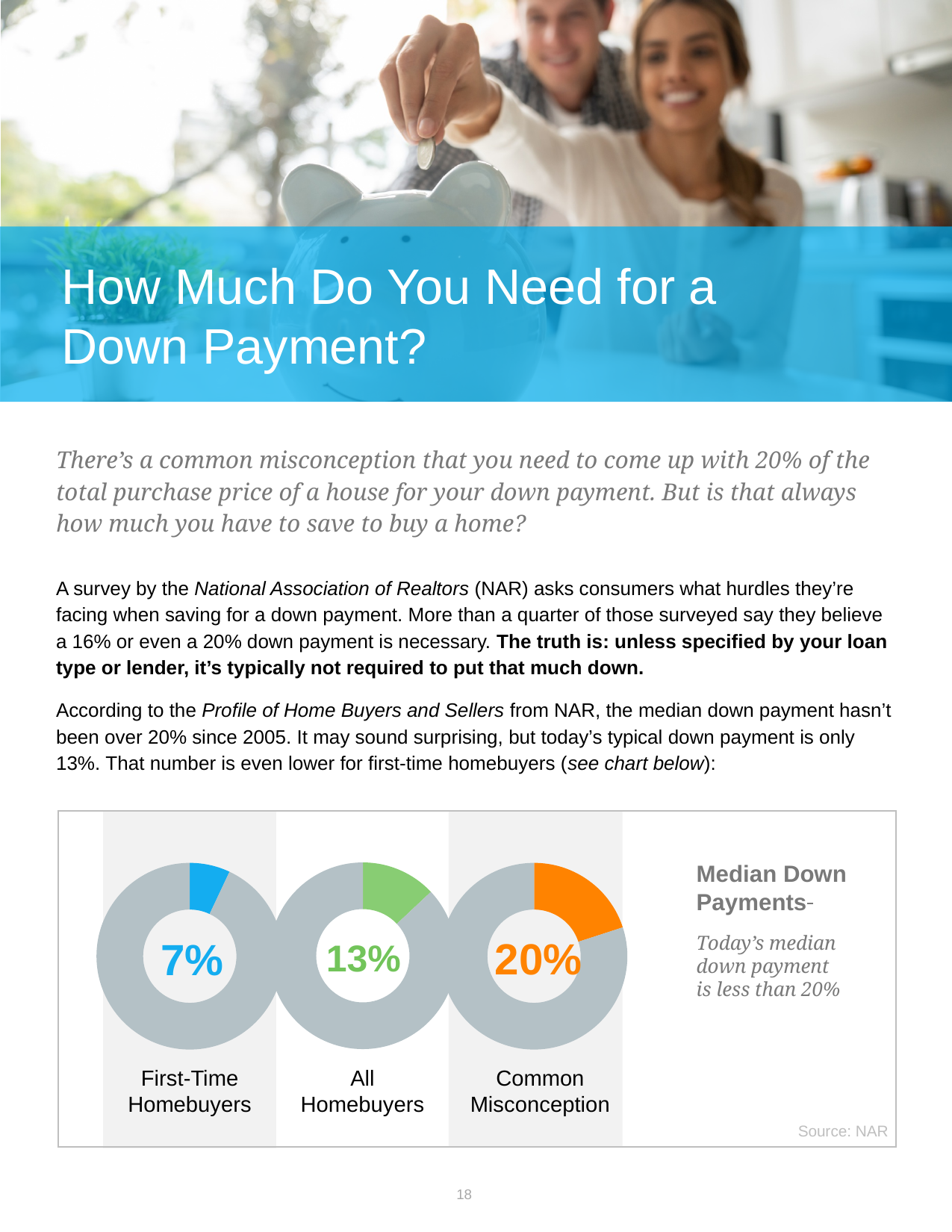
In the Median Down Payments chart, which category has the highest value? Common Misconception In the Median Down Payments chart, what is the value shown for All Homebuyers? 13% In the Median Down Payments chart, what is the difference between the All Homebuyers value and the First-Time Homebuyers value? 6% What is the source cited for the Median Down Payments chart? NAR How many donut charts are shown in the Median Down Payments graphic? 3 In the Median Down Payments chart, what is the value shown for First-Time Homebuyers? 7% In the Median Down Payments chart, what value is shown for Common Misconception? 20% What colour is the highlighted segment in the All Homebuyers donut chart? Green In the Median Down Payments chart, which category has the lowest value? First-Time Homebuyers In the Median Down Payments chart, what is the difference between the Common Misconception value and the All Homebuyers value? 7% What kind of chart is used to show the median down payments on the slide? Donut (pie) chart In the Median Down Payments chart, which is larger: the value for First-Time Homebuyers or the value for All Homebuyers? All Homebuyers